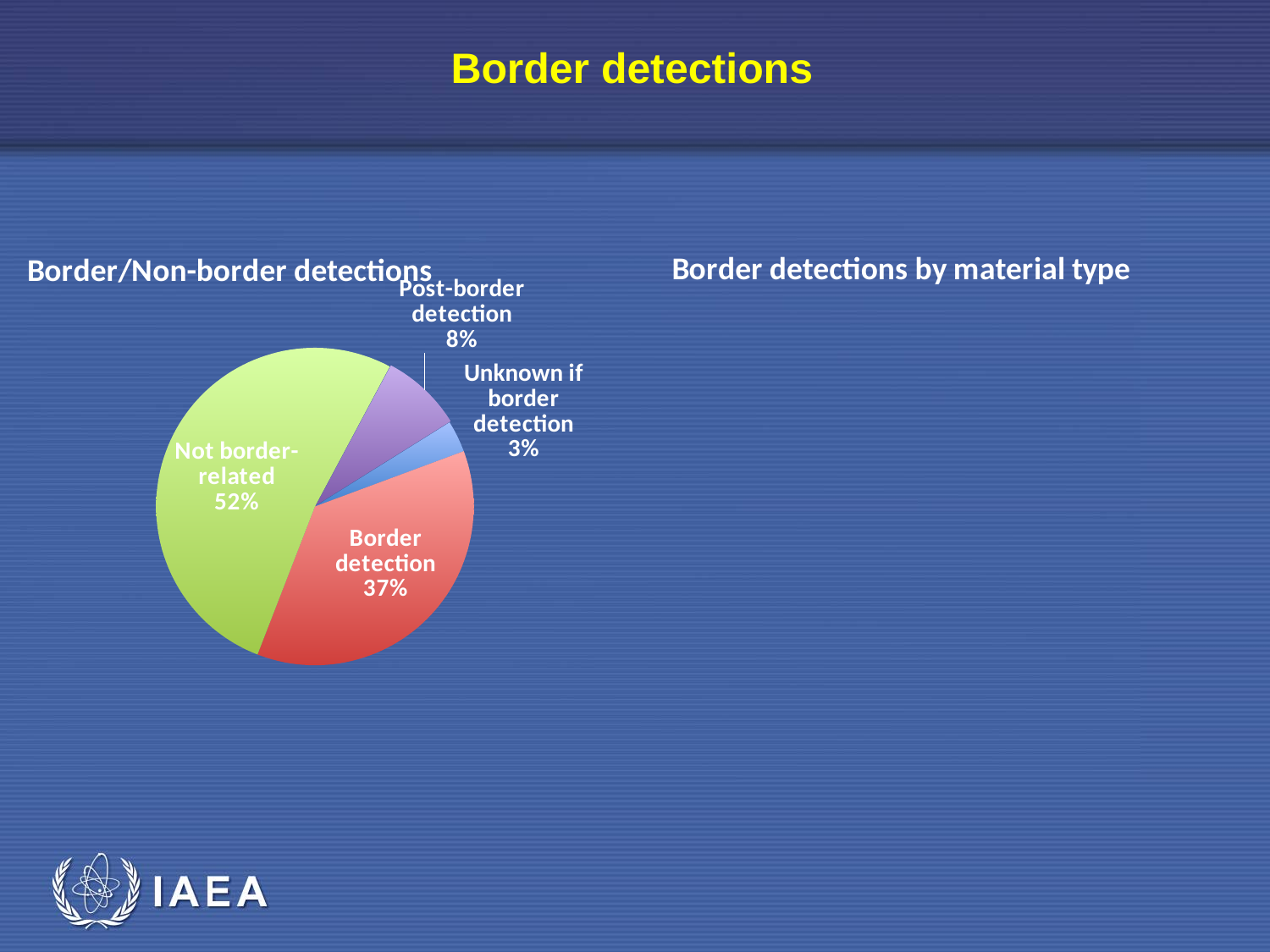
In the 'Border/Non-border detections' chart, what percentage is 'Unknown if border detection'? 3% In the 'Border/Non-border detections' chart, which category has the largest slice? Not border-related In the 'Border/Non-border detections' chart, what is the difference in percentage points between 'Not border-related' and 'Border detection'? 15 In the 'Border/Non-border detections' chart, what share of detections is 'Not border-related'? 52% How many slices does the 'Border/Non-border detections' pie chart have? 4 In the 'Border/Non-border detections' chart, which is larger: 'Post-border detection' or 'Unknown if border detection'? Post-border detection In the 'Border/Non-border detections' chart, what percentage is labelled 'Border detection'? 37% What type of chart is 'Border/Non-border detections'? Pie chart In the 'Border/Non-border detections' chart, which category has the smallest slice? Unknown if border detection In the 'Border/Non-border detections' chart, what percentage is 'Post-border detection'? 8% In the 'Border/Non-border detections' chart, what colour is the 'Border detection' slice? Red What is the title of the chart on the left side of the slide? Border/Non-border detections